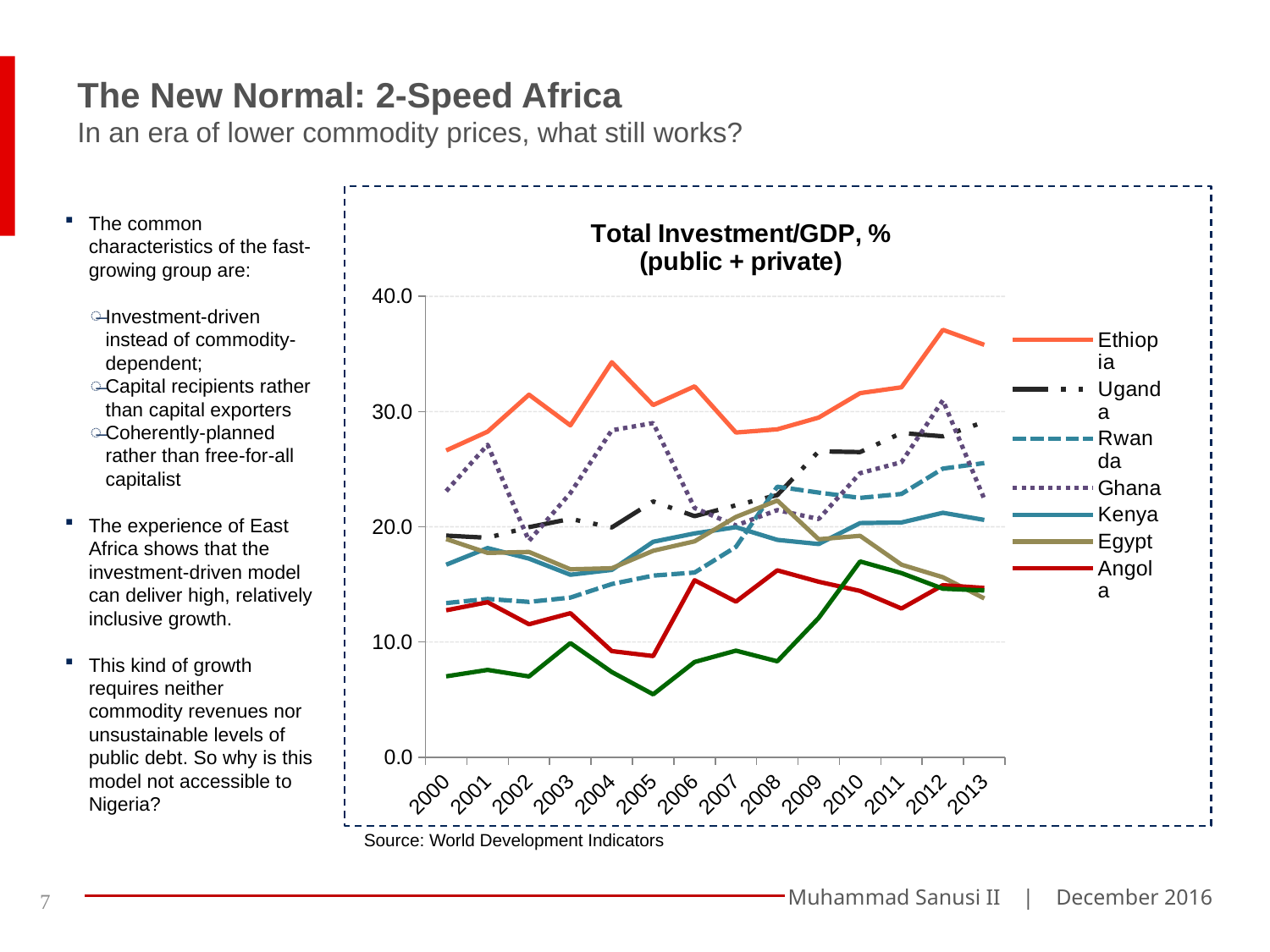
In 2004, which is larger: the value for Ghana or the value for Kenya? Ghana What kind of chart is shown on the slide? Line chart Is the value for Uganda in 2012 greater or less than 30.0? less Which country has the highest Total Investment/GDP value in 2013? Ethiopia Is the value for Rwanda in 2000 greater or less than 10.0? greater How many years are shown along the x axis of the chart? 14 Does the value for Rwanda rise or fall overall from 2000 to 2013? Rise What is the title of the chart? Total Investment/GDP, % (public + private) Is the value for Angola in 2005 greater or less than 10.0? less Which country has the highest Total Investment/GDP value in 2012? Ethiopia How many series does the chart's legend list? 7